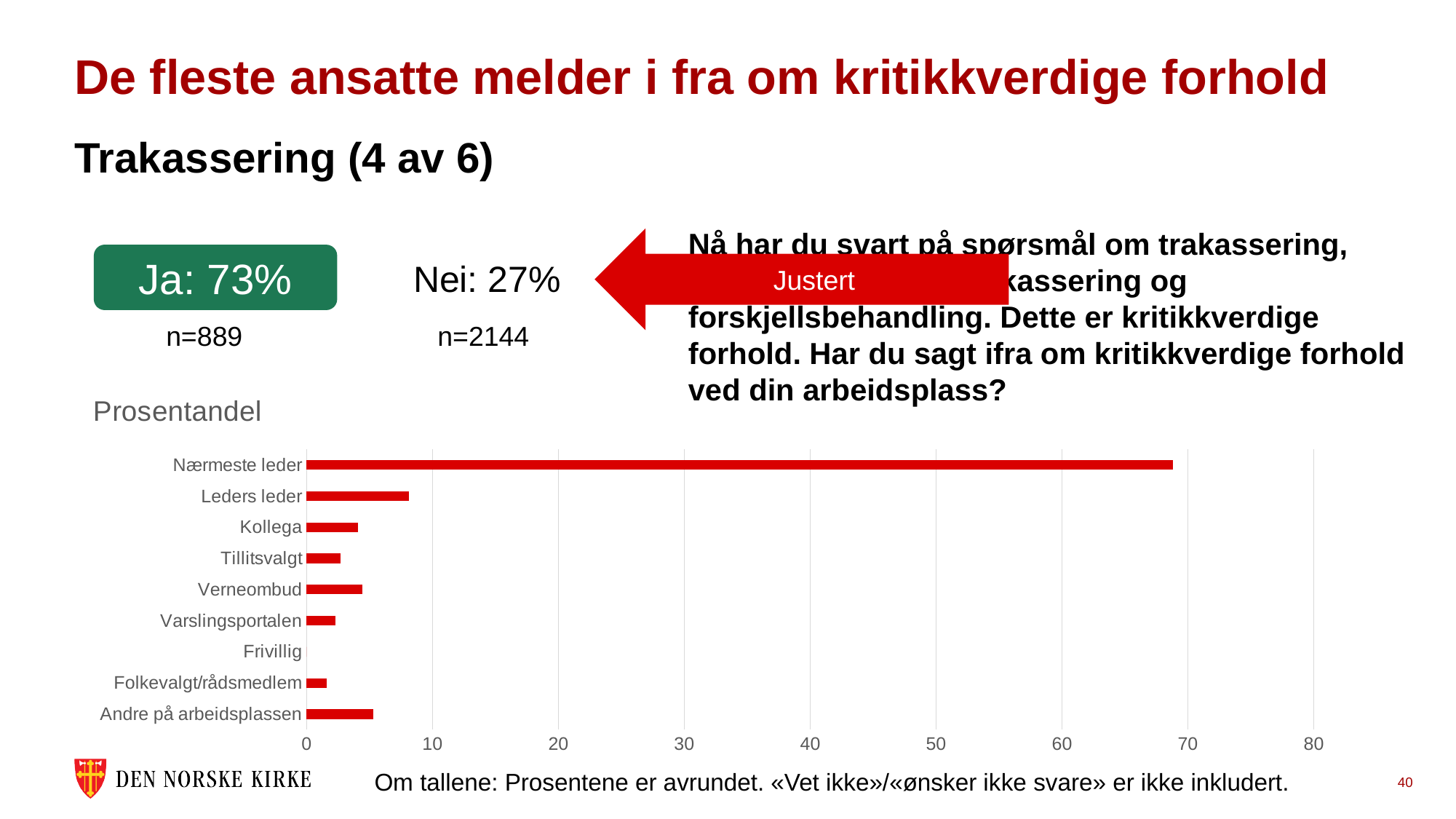
What is the title shown above the bar chart? Prosentandel Which is larger, the value for Leders leder or the value for Kollega? Leders leder Is the value for Leders leder greater or less than 10? less Is the value for Nærmeste leder greater or less than 60? greater How many categories are plotted in the bar chart? 9 Which category has the lowest value in the bar chart? Frivillig What kind of chart is shown on the slide? bar chart Is the value for Andre på arbeidsplassen greater or less than 10? less What is the highest tick value shown on the horizontal axis of the bar chart? 80 Which is larger, the value for Andre på arbeidsplassen or the value for Folkevalgt/rådsmedlem? Andre på arbeidsplassen Which category has the highest value in the bar chart? Nærmeste leder Which is larger, the value for Nærmeste leder or the value for Leders leder? Nærmeste leder